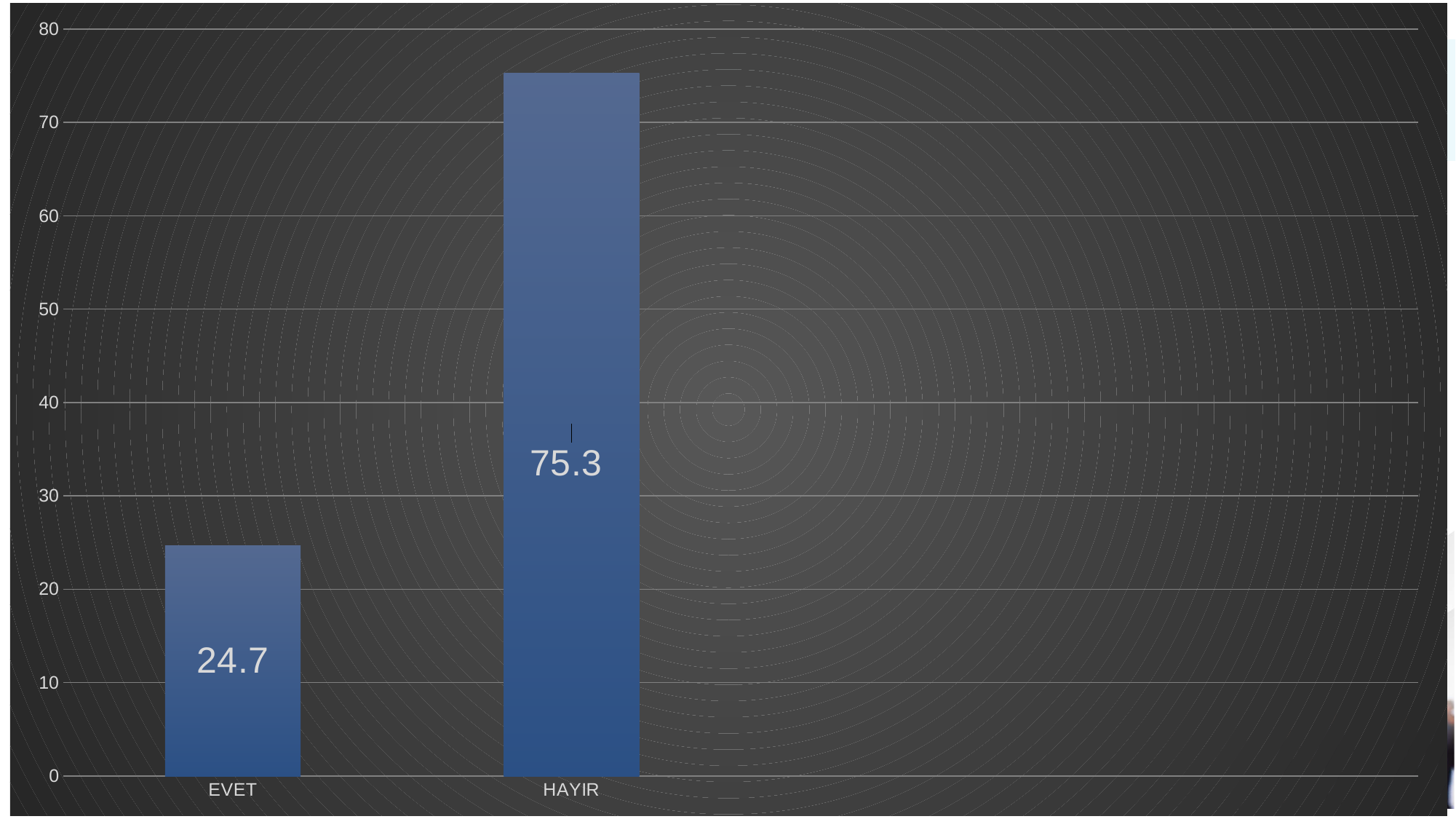
Is the value for EVET greater or less than 30? less Which is larger, the value for EVET or the value for HAYIR? HAYIR Which category has the highest value? HAYIR What is the value for HAYIR? 75.3 What is the difference between the values for HAYIR and EVET? 50.6 What kind of chart is shown on the slide? bar chart What is the highest value shown on the vertical axis? 80 How many categories are shown on the x axis? 2 Is the value for HAYIR greater or less than 70? greater What is the value for EVET? 24.7 Which category has the lowest value? EVET What is the total of the two bar values? 100